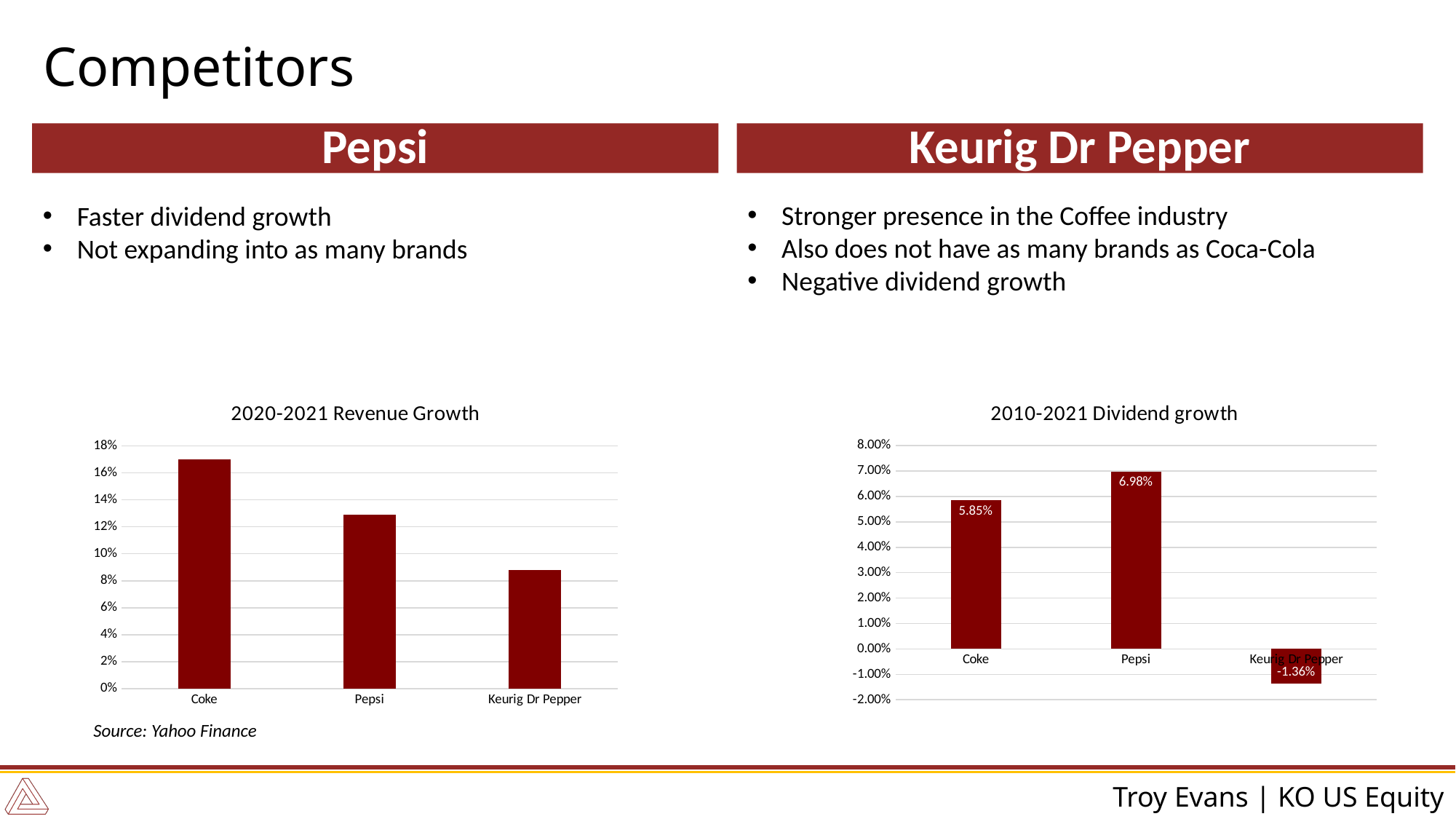
In the 2010-2021 Dividend growth chart, what is the value for Keurig Dr Pepper? -1.36% In the 2020-2021 Revenue Growth chart, which company has the highest revenue growth? Coke In the 2020-2021 Revenue Growth chart, which company has the lowest revenue growth? Keurig Dr Pepper In the 2010-2021 Dividend growth chart, which company has the highest dividend growth? Pepsi In the 2010-2021 Dividend growth chart, what is the value for Coke? 5.85% In the 2020-2021 Revenue Growth chart, is the value for Keurig Dr Pepper greater or less than 10%? less How many categories are shown in the 2020-2021 Revenue Growth chart? 3 In the 2010-2021 Dividend growth chart, which company has the lowest dividend growth? Keurig Dr Pepper In the 2010-2021 Dividend growth chart, what is the value for Pepsi? 6.98% In the 2020-2021 Revenue Growth chart, is the value for Coke greater or less than 16%? greater What type of chart is the 2010-2021 Dividend growth chart? Bar chart In the 2010-2021 Dividend growth chart, what is the difference between Pepsi's and Coke's values? 1.13%